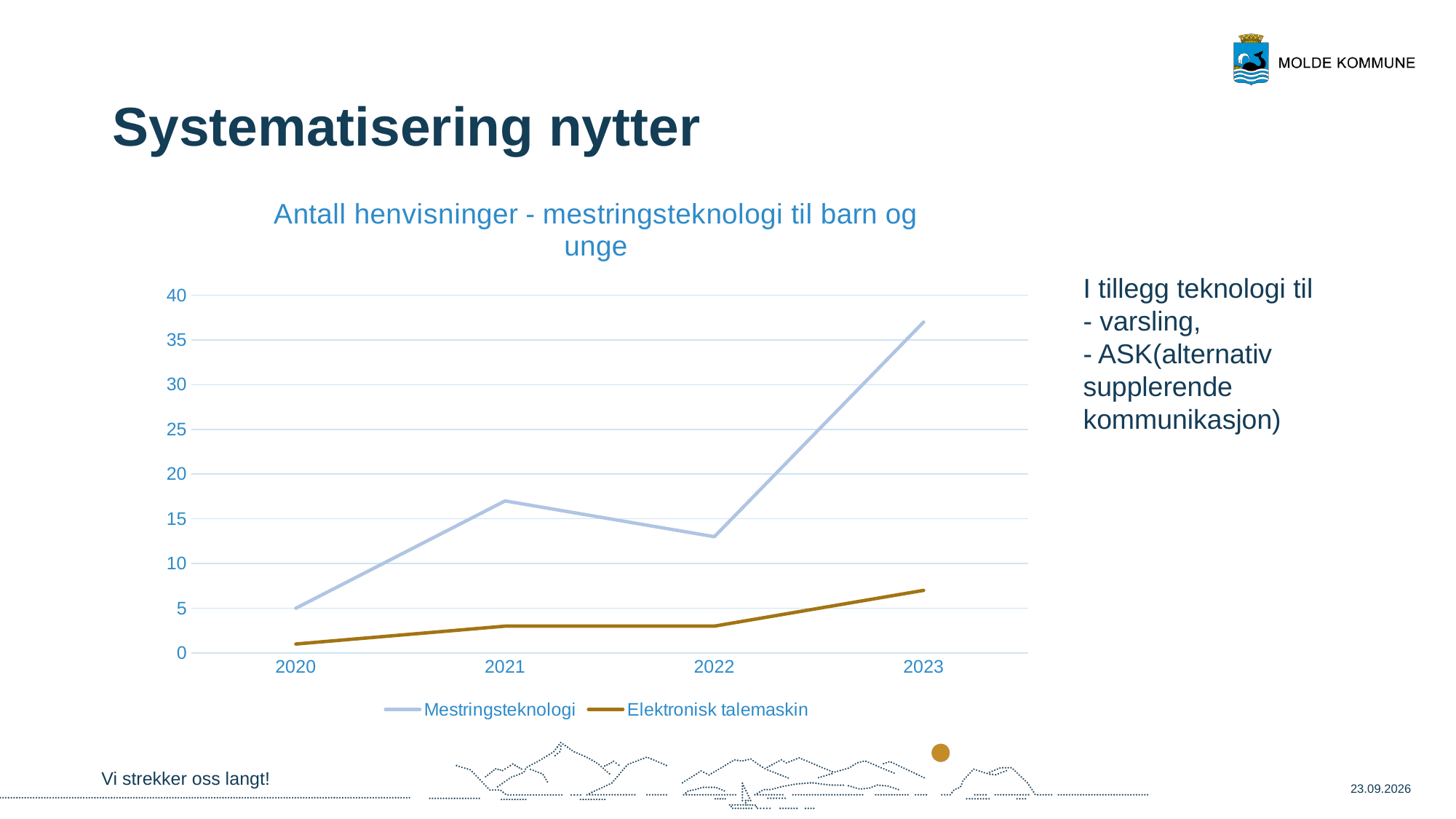
What is the title of the chart? Antall henvisninger - mestringsteknologi til barn og unge Is the value for Mestringsteknologi in 2022 greater or less than 15? less How many series does the chart legend list? 2 Is the value for Mestringsteknologi in 2023 greater or less than 35? greater What is the value for Mestringsteknologi in 2020? 5 How many years are shown on the x axis of the chart? 4 In which year is the value for Mestringsteknologi lowest? 2020 In which year is the value for Mestringsteknologi highest? 2023 What kind of chart is shown on the slide? line chart Which series has the larger value in 2023, Mestringsteknologi or Elektronisk talemaskin? Mestringsteknologi Is the value for Elektronisk talemaskin in 2023 greater or less than 10? less Does the value for Elektronisk talemaskin rise or fall from 2020 to 2023? rise